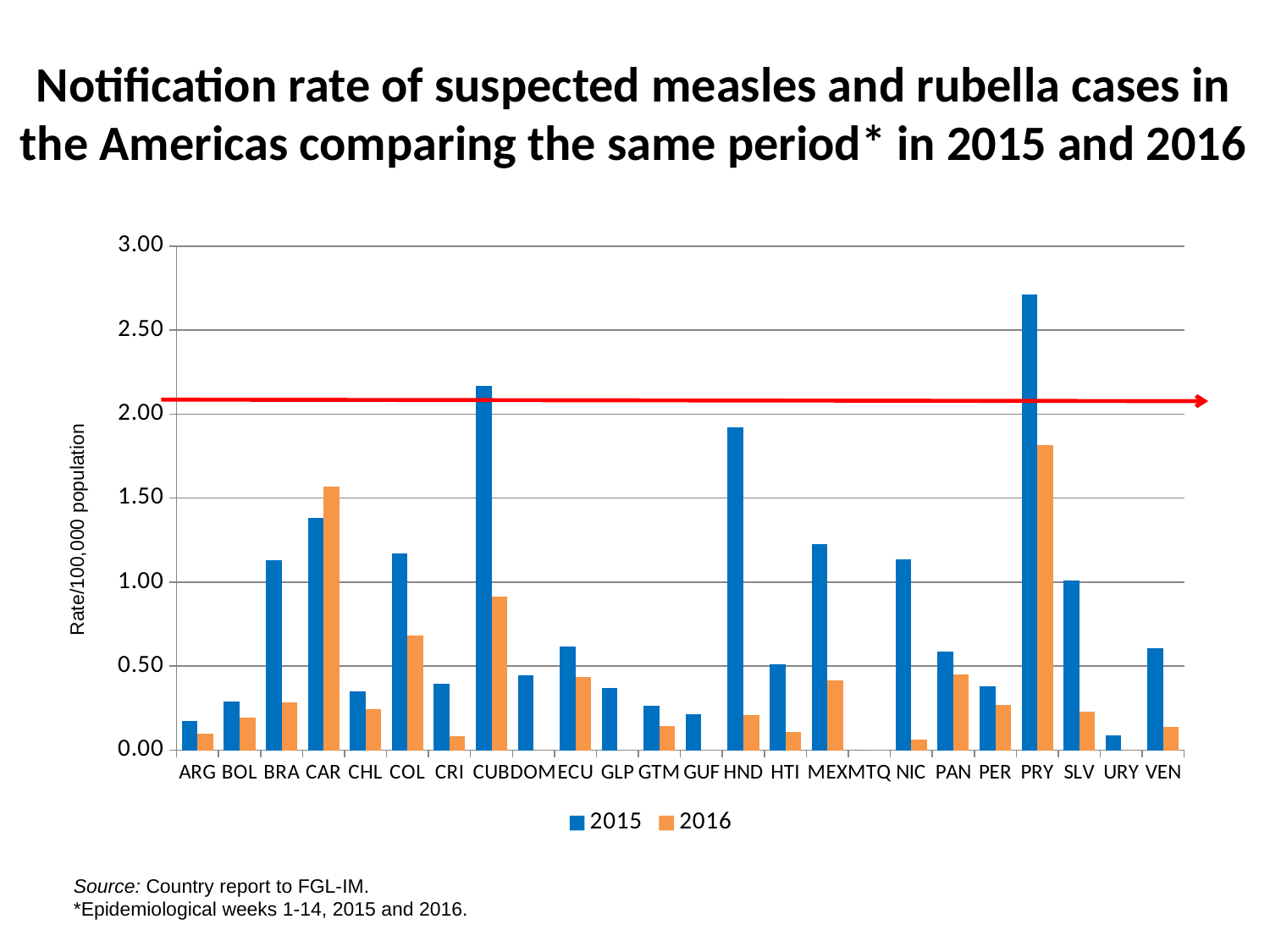
What is the label on the y axis? Rate/100,000 population Is the 2016 value for CAR greater or less than 1.50? greater How many series does the legend list? 2 Which country has the highest 2015 notification rate? PRY Is the 2015 value for CUB greater or less than 2.00? greater For CAR, which year has the larger notification rate, 2015 or 2016? 2016 Which has the larger 2015 notification rate, HND or MEX? HND How many countries or territories are shown on the x axis? 24 Which country has the highest 2016 notification rate? PRY Is the 2015 value for PRY greater or less than 2.50? greater What kind of chart is shown on the slide? bar chart